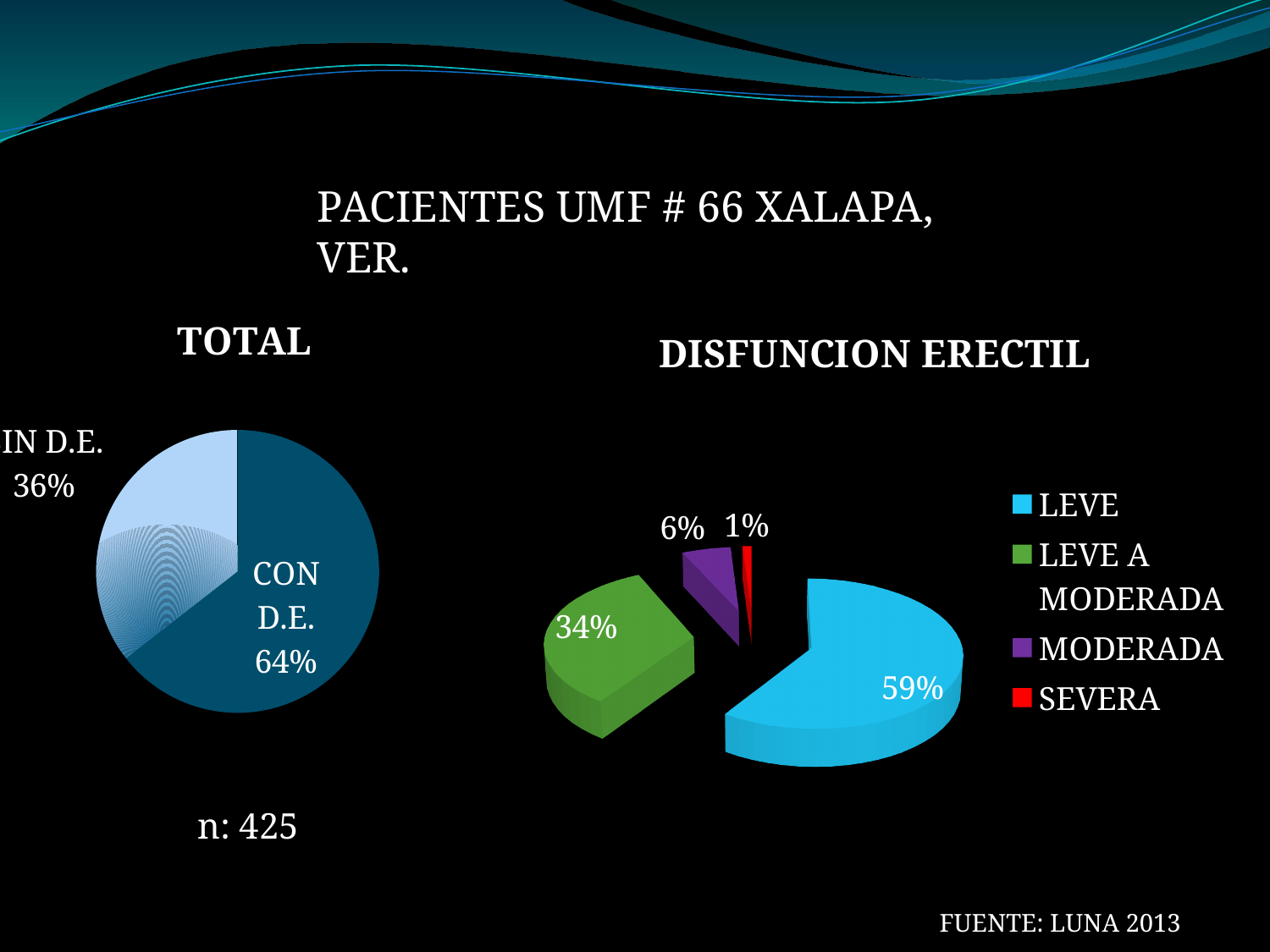
What type of chart is the DISFUNCION ERECTIL chart? Pie chart In the DISFUNCION ERECTIL pie chart, what percentage is LEVE? 59% In the TOTAL pie chart, which slice is larger, CON D.E. or SIN D.E.? CON D.E. In the DISFUNCION ERECTIL pie chart, how many categories does the legend list? 4 In the DISFUNCION ERECTIL pie chart, what percentage is MODERADA? 6% In the DISFUNCION ERECTIL pie chart, which category has the smallest share? SEVERA In the TOTAL pie chart, what is the difference in percentage points between CON D.E. and SIN D.E.? 28 In the DISFUNCION ERECTIL pie chart, what percentage is LEVE A MODERADA? 34% In the TOTAL pie chart, what percentage of patients are labelled CON D.E.? 64% In the DISFUNCION ERECTIL pie chart, what is the difference in percentage points between LEVE and LEVE A MODERADA? 25 In the TOTAL pie chart, what percentage of patients are labelled SIN D.E.? 36% In the DISFUNCION ERECTIL pie chart, which category has the largest share? LEVE